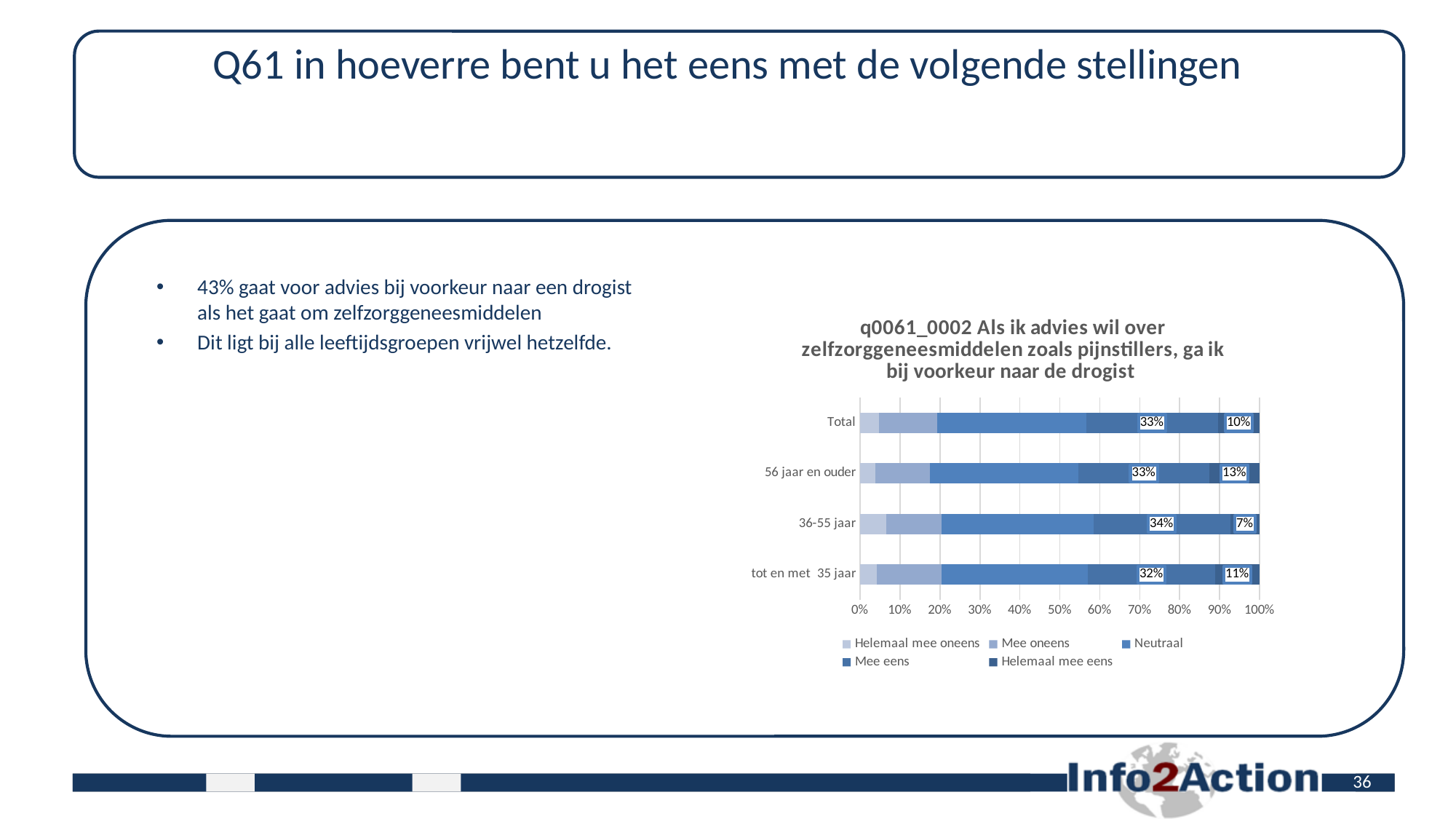
How many series does the legend list? 5 What kind of chart is shown on the slide? Stacked bar chart What is the value of 'Helemaal mee eens' for 56 jaar en ouder? 13% Which is larger: 'Mee eens' for 36-55 jaar or 'Mee eens' for tot en met 35 jaar? 36-55 jaar What is the value of 'Helemaal mee eens' for tot en met 35 jaar? 11% Which age group has the highest value for 'Helemaal mee eens'? 56 jaar en ouder Which category has the lowest value for 'Helemaal mee eens'? 36-55 jaar Is the 'Neutraal' value for Total greater or less than 30%? greater What is the value of 'Mee eens' for 36-55 jaar? 34% What is the difference in 'Helemaal mee eens' between 56 jaar en ouder and 36-55 jaar? 6 percentage points What is the value of 'Mee eens' for Total? 33% How many categories (bars) are shown in the chart? 4